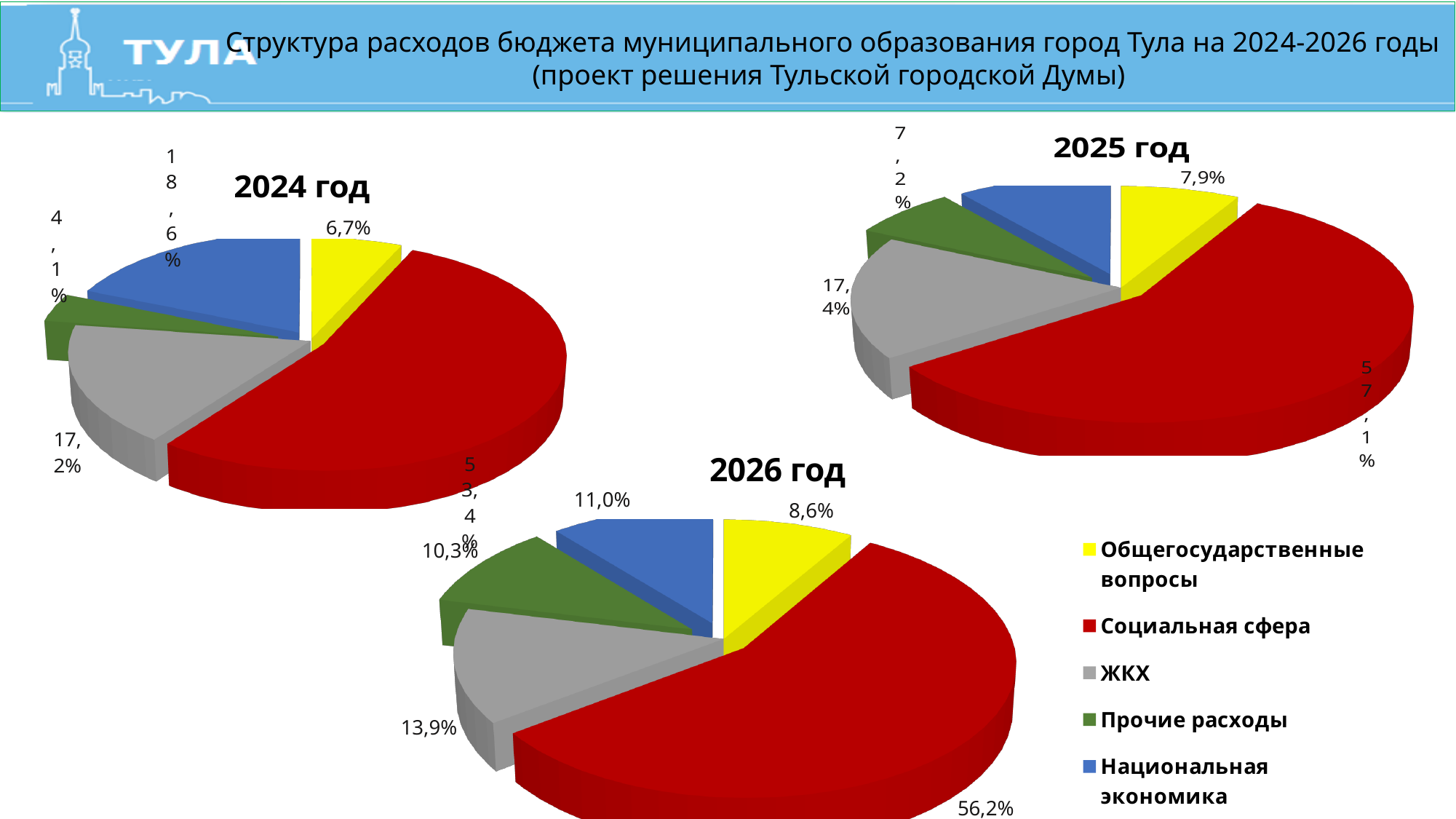
In the 2024 год pie chart, what share is shown for Социальная сфера? 53,4% How many categories does the legend list for the pie charts? 5 In the 2025 год pie chart, what share is shown for ЖКХ? 17,4% In the 2026 год pie chart, what is the difference between the shares of Национальная экономика and Прочие расходы? 0,7% In the 2025 год pie chart, what share is shown for Общегосударственные вопросы? 7,9% In the 2024 год pie chart, what share is shown for Прочие расходы? 4,1% In the 2026 год pie chart, what share is shown for Социальная сфера? 56,2% In the 2024 год pie chart, which is larger: the share of ЖКХ or the share of Национальная экономика? Национальная экономика In the 2026 год pie chart, which category has the smallest share? Общегосударственные вопросы In the 2024 год pie chart, which category has the largest share? Социальная сфера In the 2024 год pie chart, what share is shown for Национальная экономика? 18,6% What type of chart is used for 2025 год? Pie chart